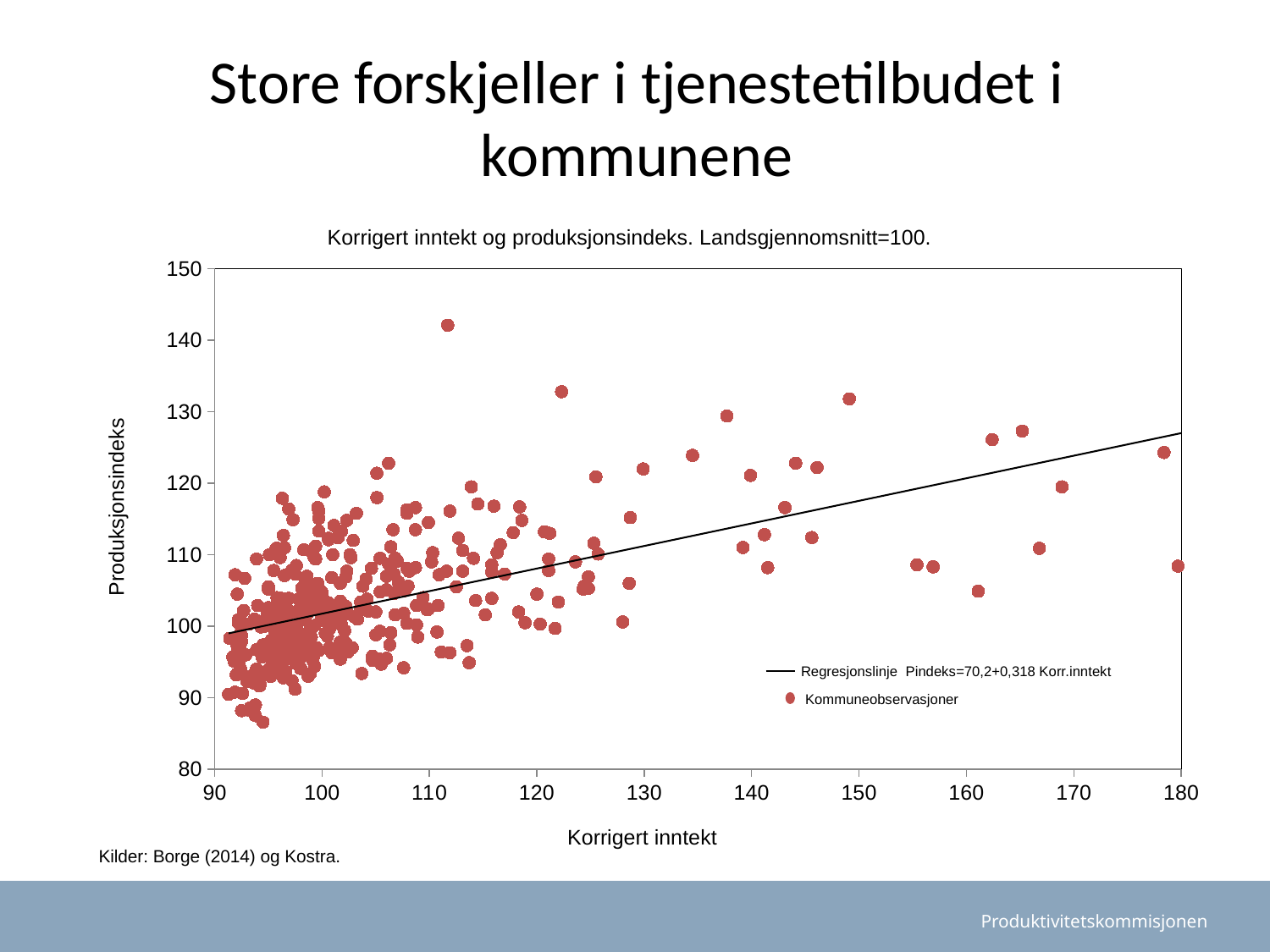
Is the lowest Kommuneobservasjoner point greater or less than 90 on the Produksjonsindeks axis? less What is the maximum value shown on the x axis? 180 What is the label of the y axis? Produksjonsindeks What is the label of the x axis? Korrigert inntekt Does the regression line rise or fall as Korrigert inntekt increases? Rises How many series does the legend list? 2 Is the regression line value at Korrigert inntekt = 180 greater or less than 120? greater Is the highest Kommuneobservasjoner point greater or less than 140 on the Produksjonsindeks axis? greater What kind of chart is shown on the slide? Scatter plot